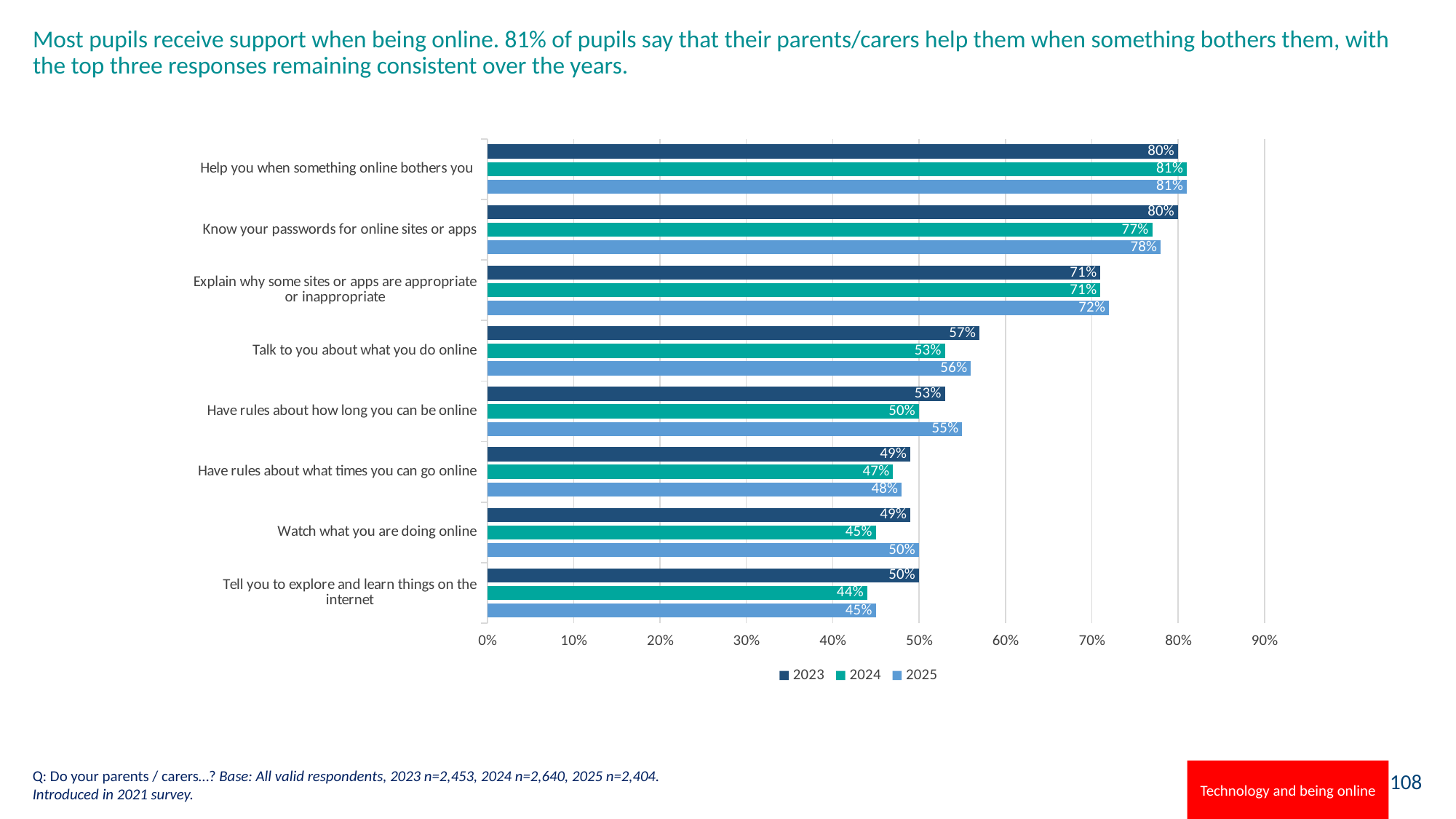
How many categories are shown on the chart? 8 How many series does the legend list? 3 What kind of chart is shown on the slide? Bar chart Which category has the lowest 2024 value? Tell you to explore and learn things on the internet What is the 2025 value for "Have rules about how long you can be online"? 55% Which category has the highest 2025 value? Help you when something online bothers you What is the 2025 value for "Help you when something online bothers you"? 81% What is the 2023 value for "Talk to you about what you do online"? 57% Which years are listed in the legend? 2023, 2024, 2025 What is the difference between the 2023 and 2024 values for "Watch what you are doing online"? 4% Which is larger for "Tell you to explore and learn things on the internet": the 2023 value or the 2025 value? 2023 What is the 2024 value for "Know your passwords for online sites or apps"? 77%